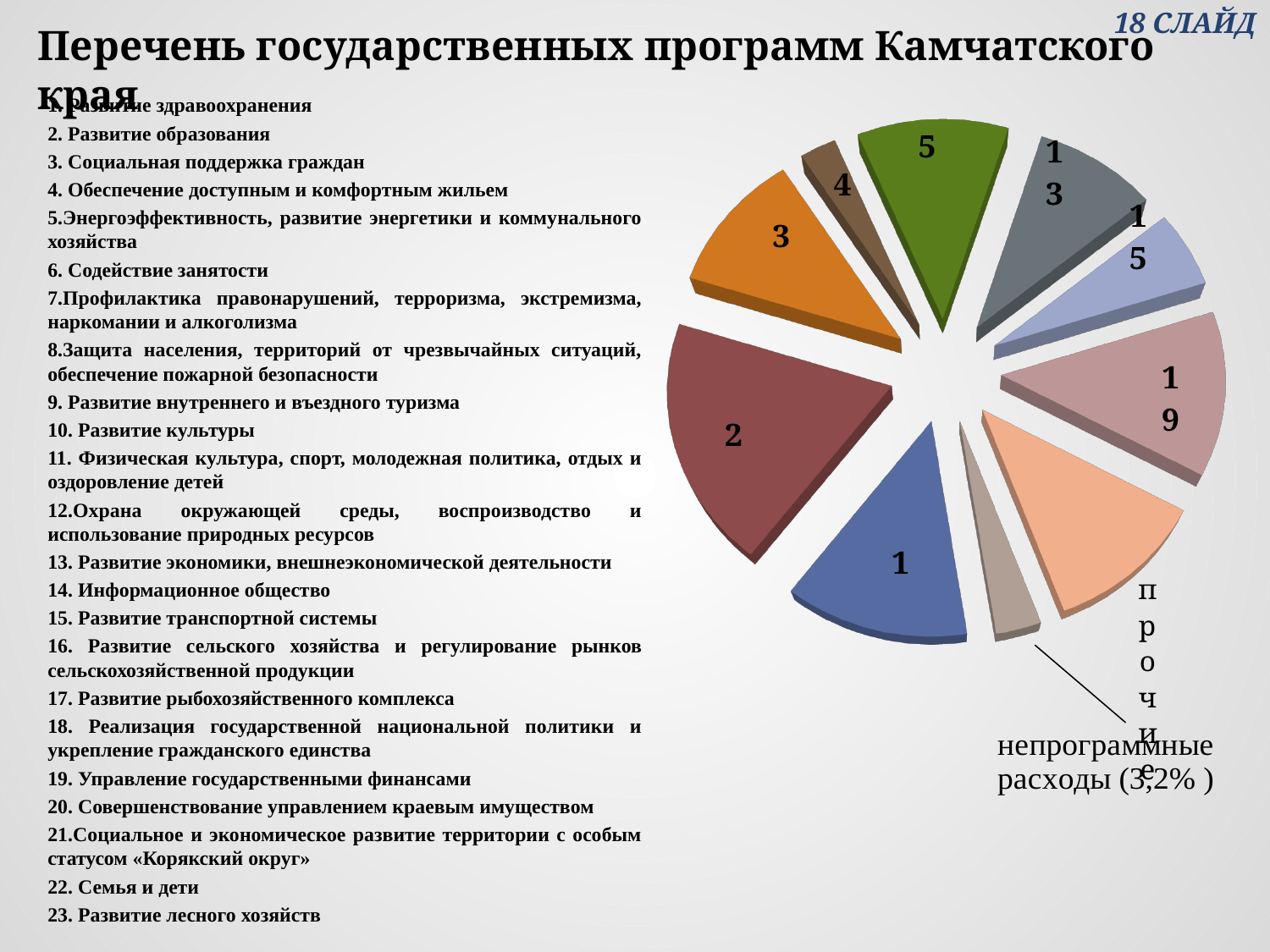
What share of the pie is labelled for непрограммные расходы? 3,2% What is the title of the slide containing the pie chart? Перечень государственных программ Камчатского края Which slice is larger, the one labelled 2 or the one labelled 19? 2 Which slice is larger, the one labelled 19 or the one labelled 13? 19 Which slice of the pie chart is the largest? 2 Which slice is larger, the one labelled 2 or the one labelled 3? 2 Which program number is shown on the green slice of the pie chart? 5 How many slices does the pie chart have? 10 What kind of chart is shown on the slide? pie chart